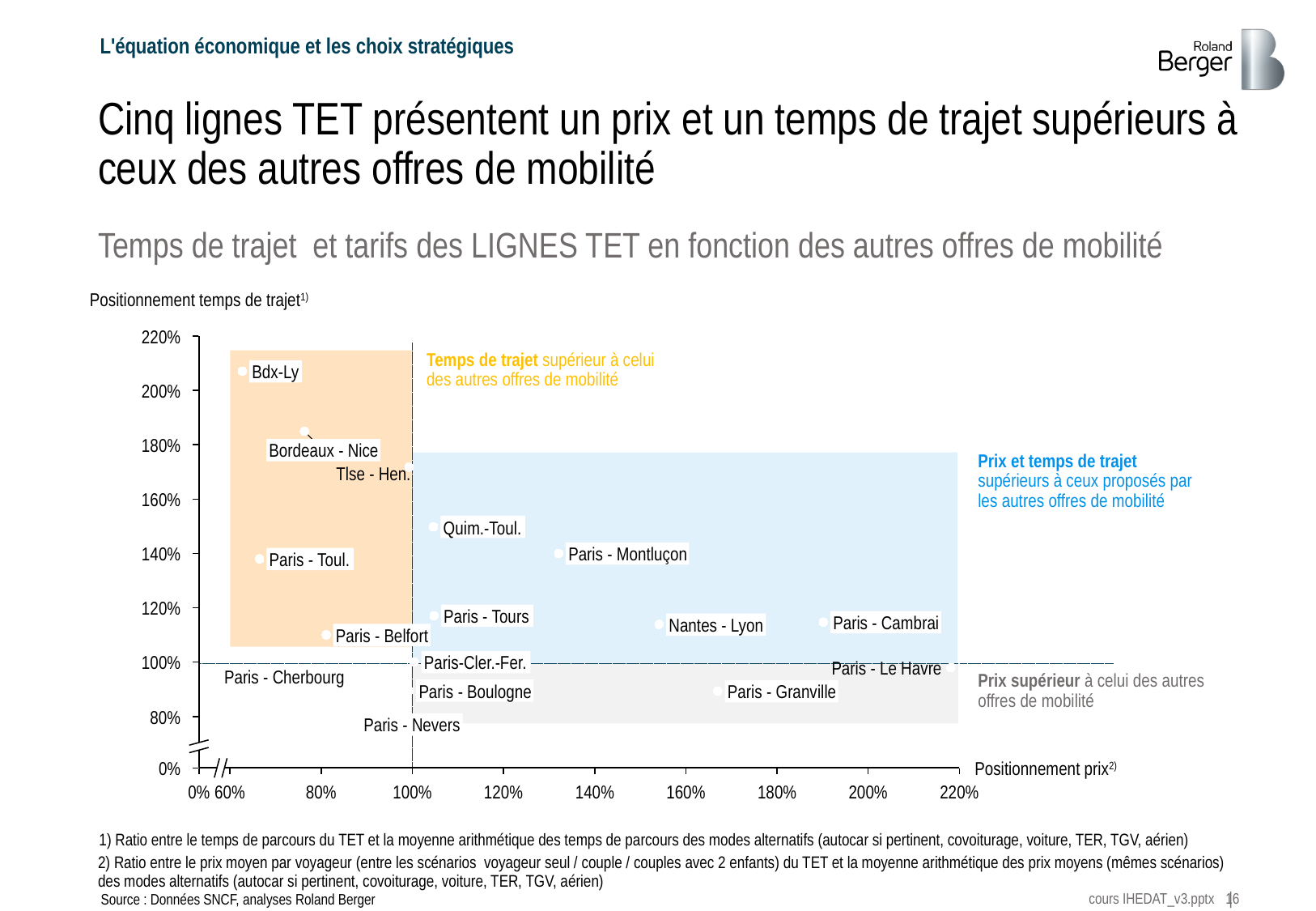
Which has the higher price positioning, Nantes - Lyon or Paris - Cambrai? Paris - Cambrai Is the travel-time positioning for Bdx-Ly greater or less than 200%? greater What is the label of the horizontal axis of the chart? Positionnement prix Is the price positioning for Paris - Montluçon greater or less than 120%? greater What is the title of the chart? Temps de trajet et tarifs des LIGNES TET en fonction des autres offres de mobilité Which has the higher travel-time positioning, Bdx-Ly or Paris - Toul.? Bdx-Ly What kind of chart is shown on the slide? Scatter chart Which line has the highest price positioning (Positionnement prix)? Paris - Le Havre Is the price positioning for Paris - Cambrai greater or less than 180%? greater Which line has the highest travel-time positioning (Positionnement temps de trajet)? Bdx-Ly How many TET lines are plotted as labelled points on the chart? 16